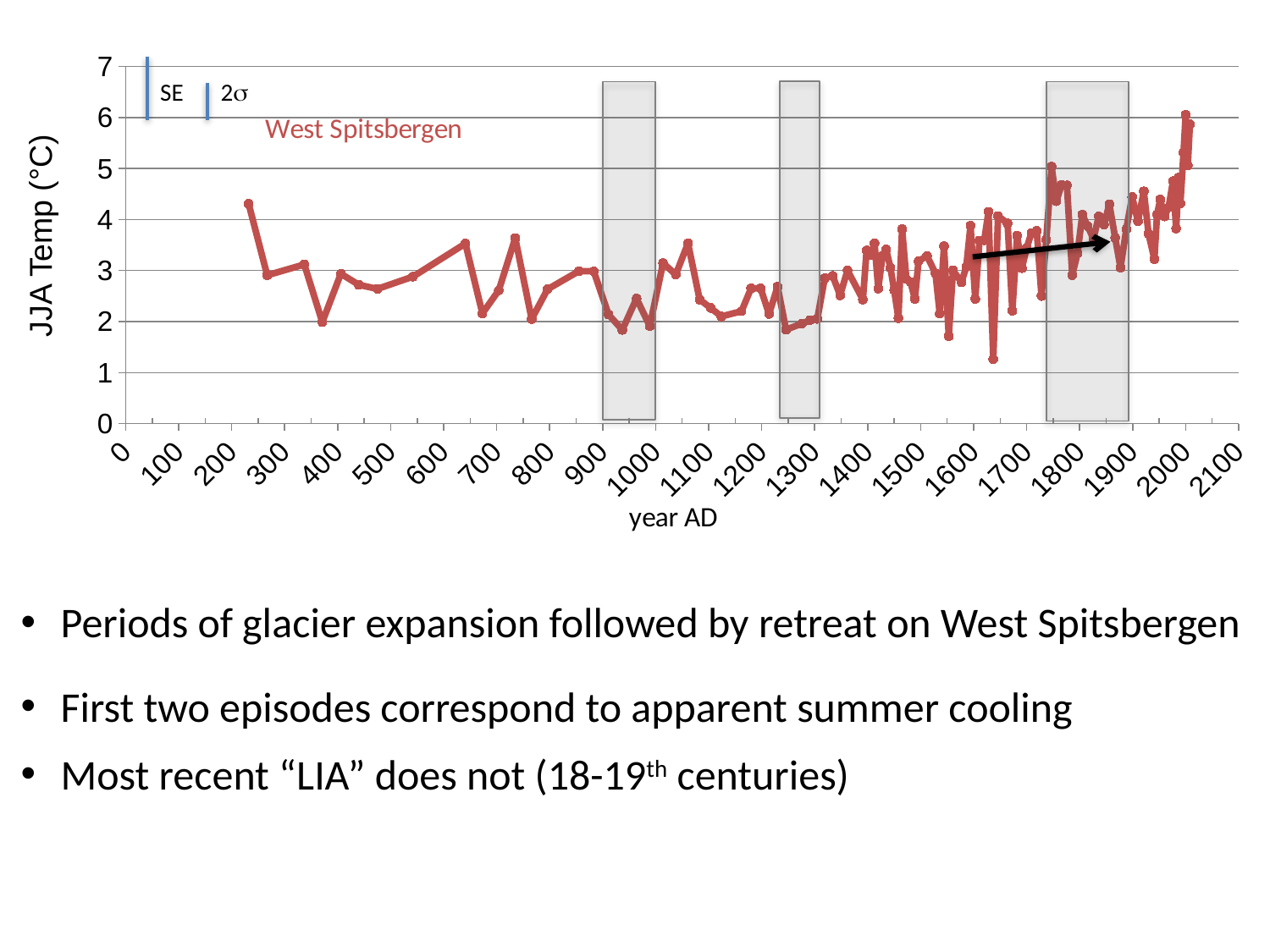
What is the label of the y-axis? JJA Temp (°C) What is the label of the x-axis? year AD Is the value near year 2000 larger or smaller than the value near year 1000? larger Around which year does the series reach its lowest value? around 1650 Around which year does the series reach its highest value? around 2000 Do the values generally rise or fall from year 1400 to year 2000? rise Is the lowest value near year 1650 greater or less than 2? less Is the value for the point near year 650 greater or less than 3? greater Is the value for the point near year 2000 greater or less than 5? greater What kind of chart is shown on the slide? line chart